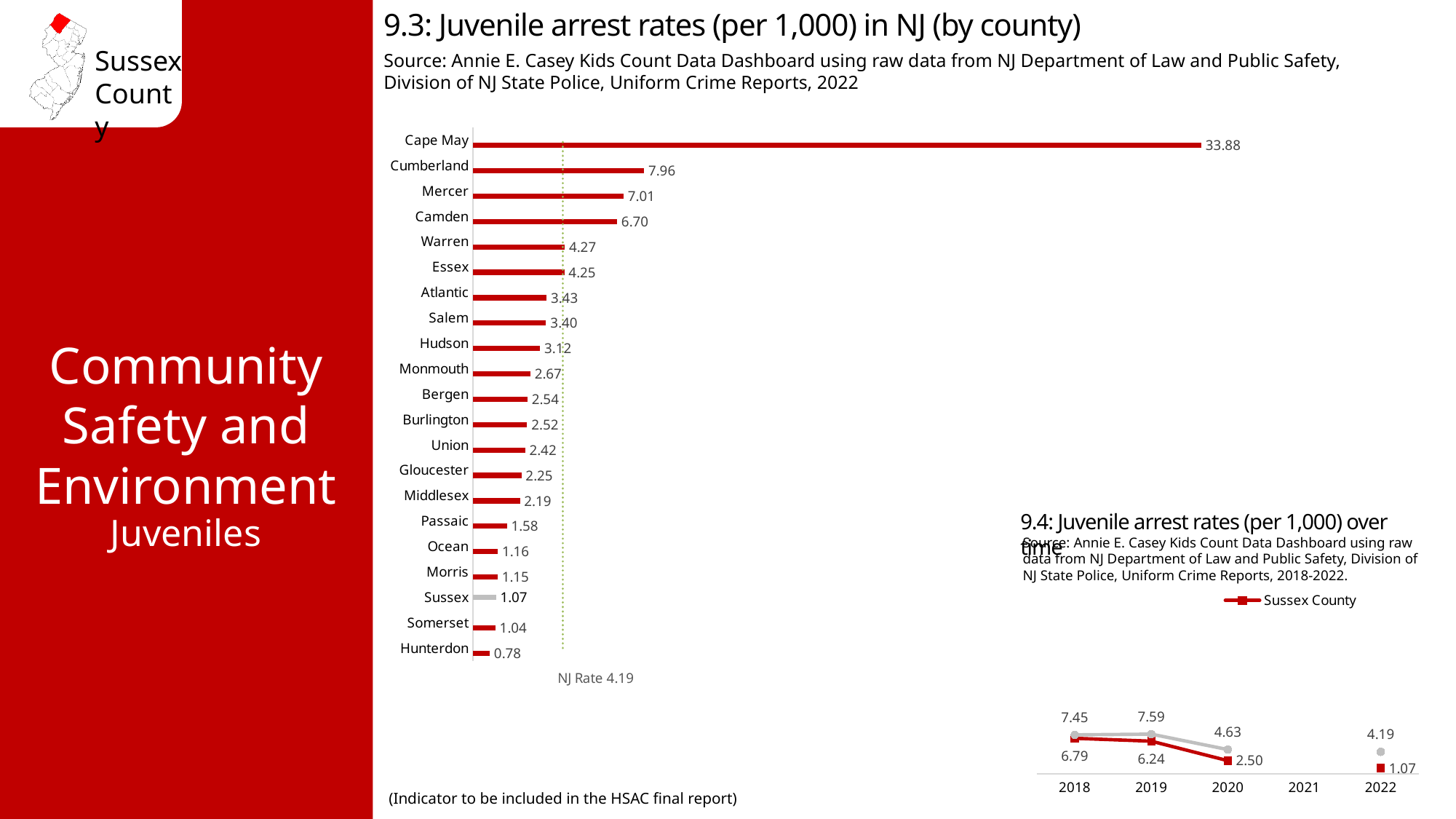
In the chart '9.4: Juvenile arrest rates (per 1,000) over time', what is the difference between the Sussex County values for 2018 and 2019? 0.55 In the chart '9.3: Juvenile arrest rates (per 1,000) in NJ (by county)', what NJ rate is marked by the dotted reference line? 4.19 In the chart '9.3: Juvenile arrest rates (per 1,000) in NJ (by county)', which is larger, Camden or Warren? Camden In the chart '9.3: Juvenile arrest rates (per 1,000) in NJ (by county)', what is the difference between Cumberland and Mercer? 0.95 In the chart '9.3: Juvenile arrest rates (per 1,000) in NJ (by county)', what is the value for Sussex? 1.07 In the chart '9.3: Juvenile arrest rates (per 1,000) in NJ (by county)', which county has the highest rate? Cape May How many counties are shown in the chart '9.3: Juvenile arrest rates (per 1,000) in NJ (by county)'? 21 In the chart '9.3: Juvenile arrest rates (per 1,000) in NJ (by county)', what is the value for Cape May? 33.88 In the chart '9.3: Juvenile arrest rates (per 1,000) in NJ (by county)', which county has the lowest rate? Hunterdon In the chart '9.4: Juvenile arrest rates (per 1,000) over time', does the Sussex County rate rise or fall from 2018 to 2022? Fall What kind of chart is '9.3: Juvenile arrest rates (per 1,000) in NJ (by county)'? Bar chart In the chart '9.4: Juvenile arrest rates (per 1,000) over time', what is the Sussex County value for 2020? 2.50